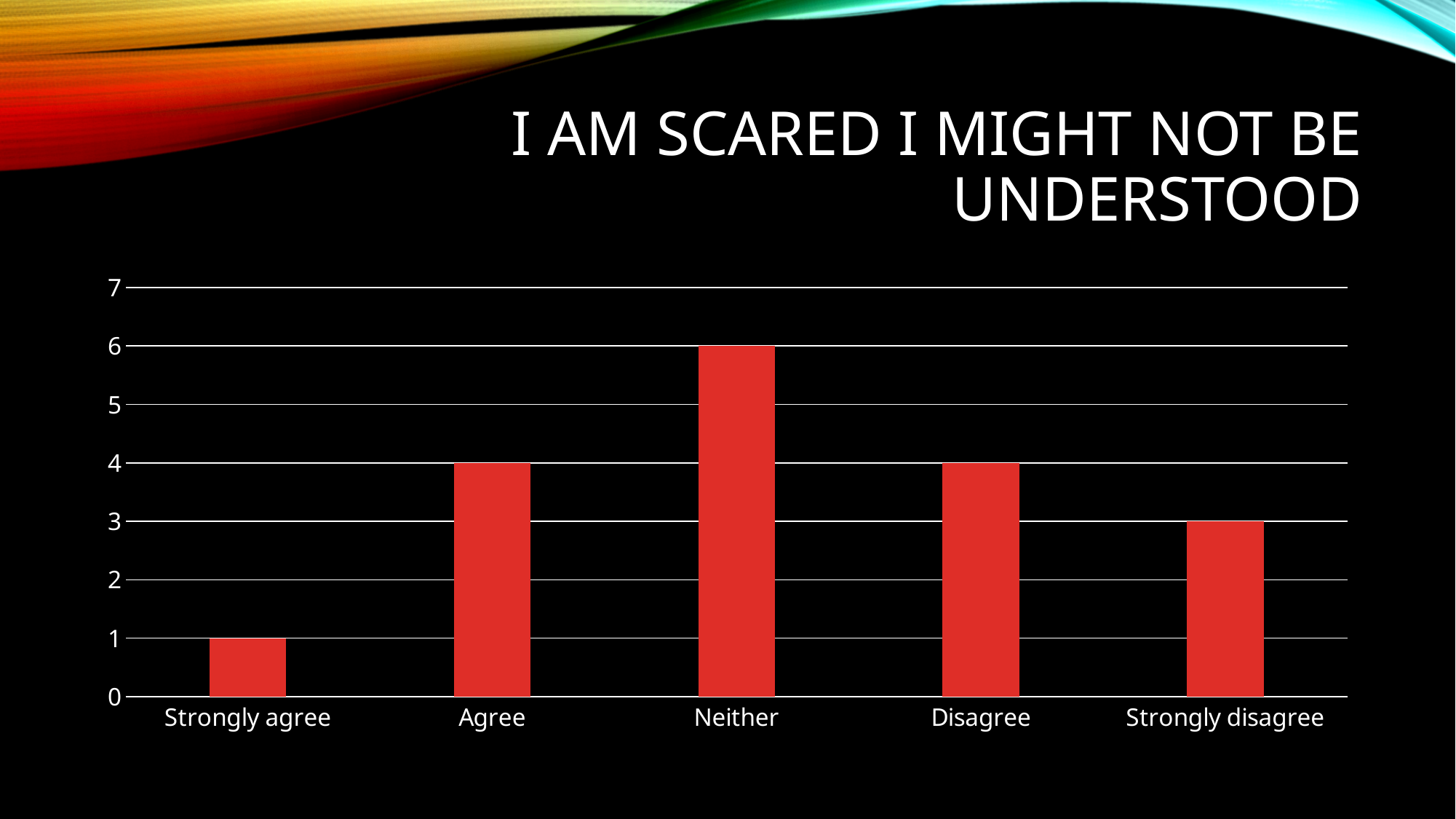
What is the difference between the values for Neither and Strongly agree? 5 Which category has the lowest value? Strongly agree What is the value for Strongly disagree? 3 Which is larger, the value for Neither or the value for Disagree? Neither What is the difference between the values for Agree and Strongly disagree? 1 What kind of chart is shown on the slide? bar chart What is the value for Neither? 6 Is the value for Neither greater or less than 5? greater Which category has the highest value? Neither How many categories are shown on the x axis? 5 What is the value for Strongly agree? 1 What is the title of the slide? I am scared I might not be understood